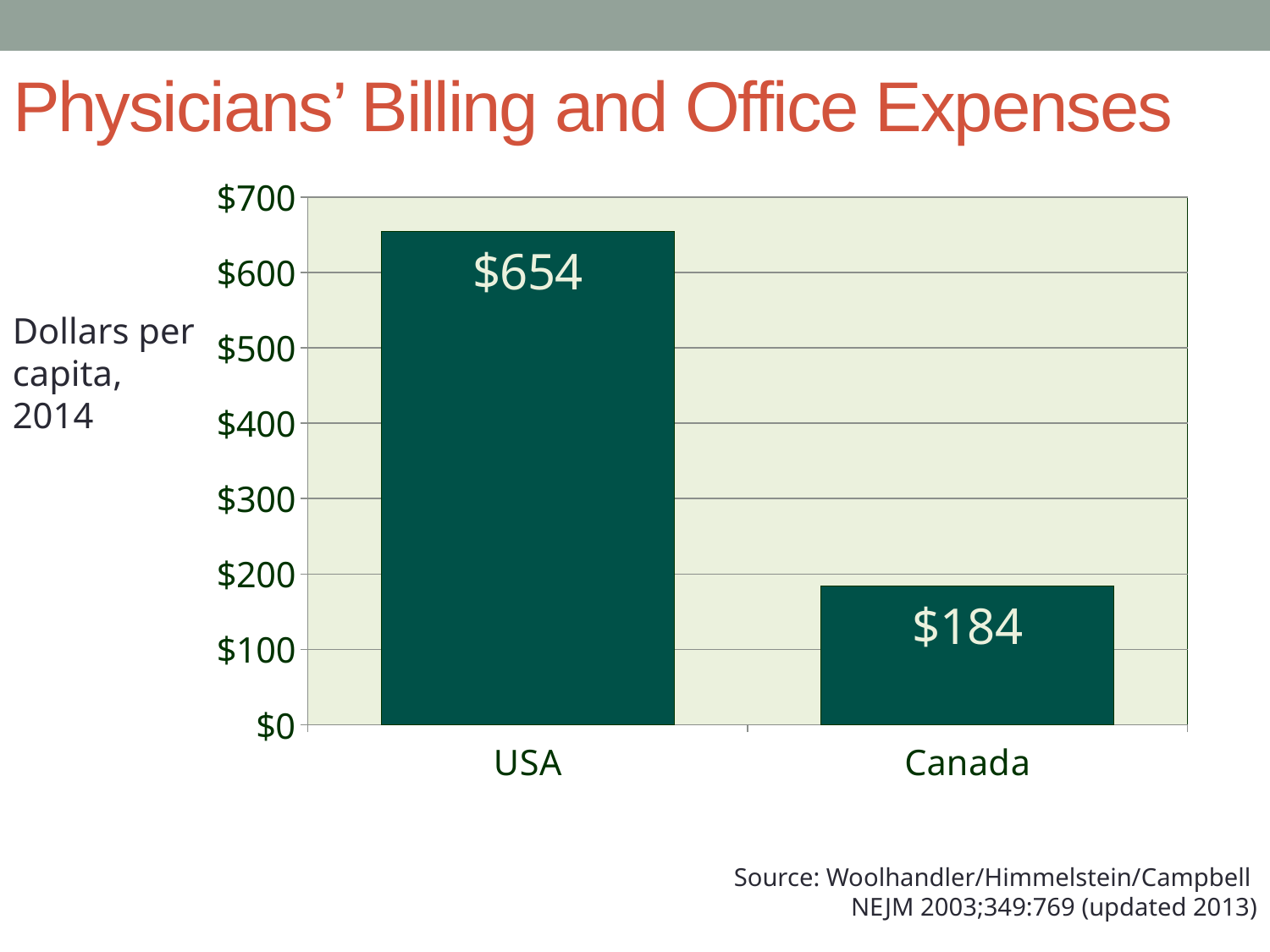
Which is larger, the value for USA or the value for Canada? USA What unit is the y axis measured in, according to the label on the slide? Dollars per capita, 2014 What is the value for Canada? $184 How many countries are shown in the chart? 2 Is the value for Canada greater or less than $200? less What is the value for USA? $654 What is the difference between the USA and Canada values? $470 Which country has the highest physicians' billing and office expenses per capita? USA Is the value for USA greater or less than $600? greater What is the title of the slide? Physicians' Billing and Office Expenses Which country has the lowest physicians' billing and office expenses per capita? Canada What kind of chart is shown on the slide? bar chart